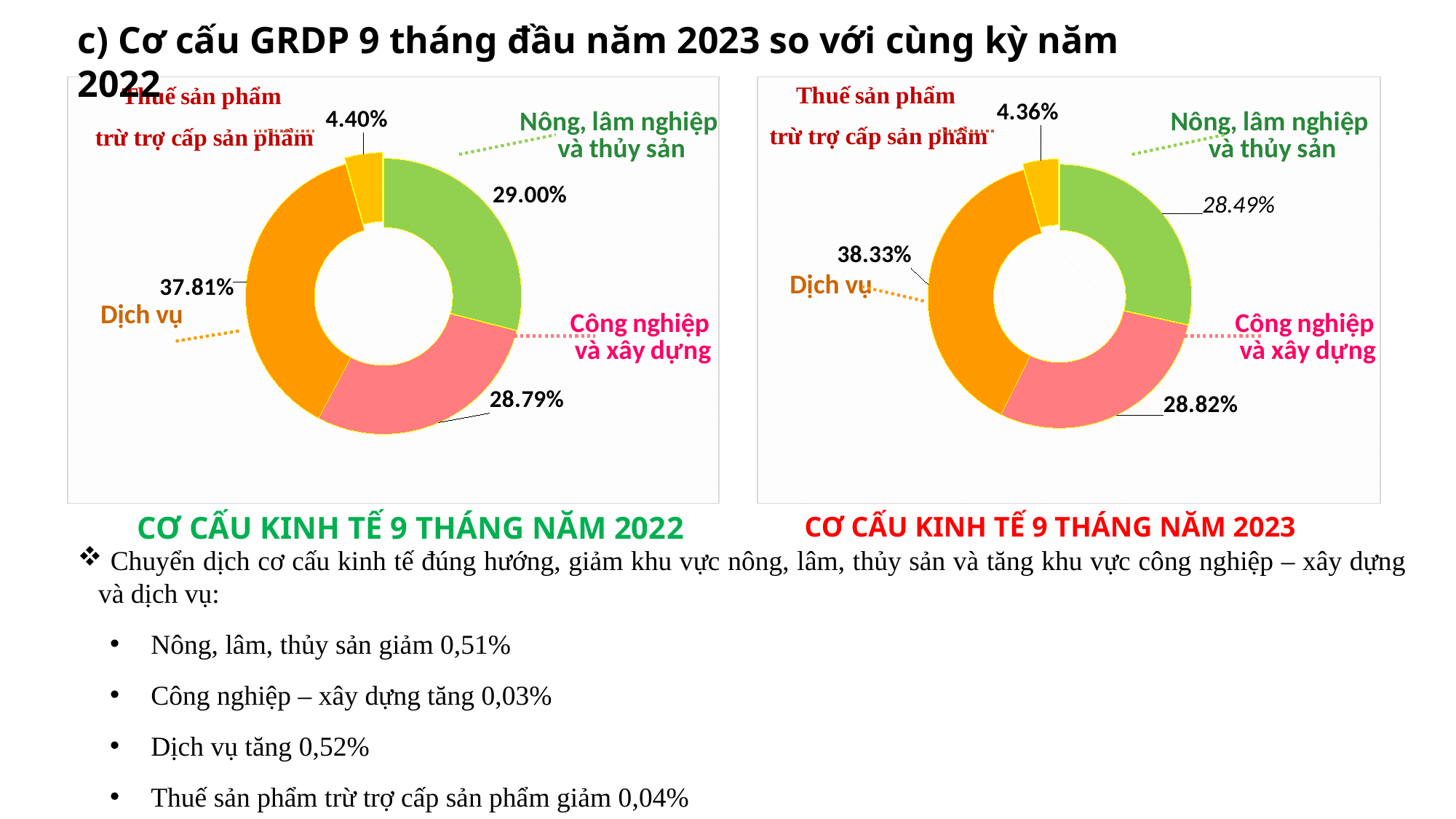
In the chart titled 'CƠ CẤU KINH TẾ 9 THÁNG NĂM 2022', which category has the smallest share? Thuế sản phẩm trừ trợ cấp sản phẩm In the chart titled 'CƠ CẤU KINH TẾ 9 THÁNG NĂM 2022', what is the value for 'Thuế sản phẩm trừ trợ cấp sản phẩm'? 4.40% In the chart titled 'CƠ CẤU KINH TẾ 9 THÁNG NĂM 2022', what is the difference between the shares of 'Dịch vụ' and 'Nông, lâm nghiệp và thủy sản'? 8.81% In the chart titled 'CƠ CẤU KINH TẾ 9 THÁNG NĂM 2023', which category has the largest share? Dịch vụ In the chart titled 'CƠ CẤU KINH TẾ 9 THÁNG NĂM 2023', what share does 'Nông, lâm nghiệp và thủy sản' have? 28.49% What kind of chart is the chart titled 'CƠ CẤU KINH TẾ 9 THÁNG NĂM 2023'? Doughnut chart In the chart titled 'CƠ CẤU KINH TẾ 9 THÁNG NĂM 2023', what is the difference between the shares of 'Dịch vụ' and 'Công nghiệp và xây dựng'? 9.51% In the chart titled 'CƠ CẤU KINH TẾ 9 THÁNG NĂM 2023', which is larger: 'Công nghiệp và xây dựng' or 'Thuế sản phẩm trừ trợ cấp sản phẩm'? Công nghiệp và xây dựng How many categories are shown in the chart titled 'CƠ CẤU KINH TẾ 9 THÁNG NĂM 2022'? 4 In the chart titled 'CƠ CẤU KINH TẾ 9 THÁNG NĂM 2022', what colour is the 'Dịch vụ' slice? Orange In the chart titled 'CƠ CẤU KINH TẾ 9 THÁNG NĂM 2022', what share does 'Dịch vụ' have? 37.81% In the chart titled 'CƠ CẤU KINH TẾ 9 THÁNG NĂM 2023', what is the value for 'Công nghiệp và xây dựng'? 28.82%